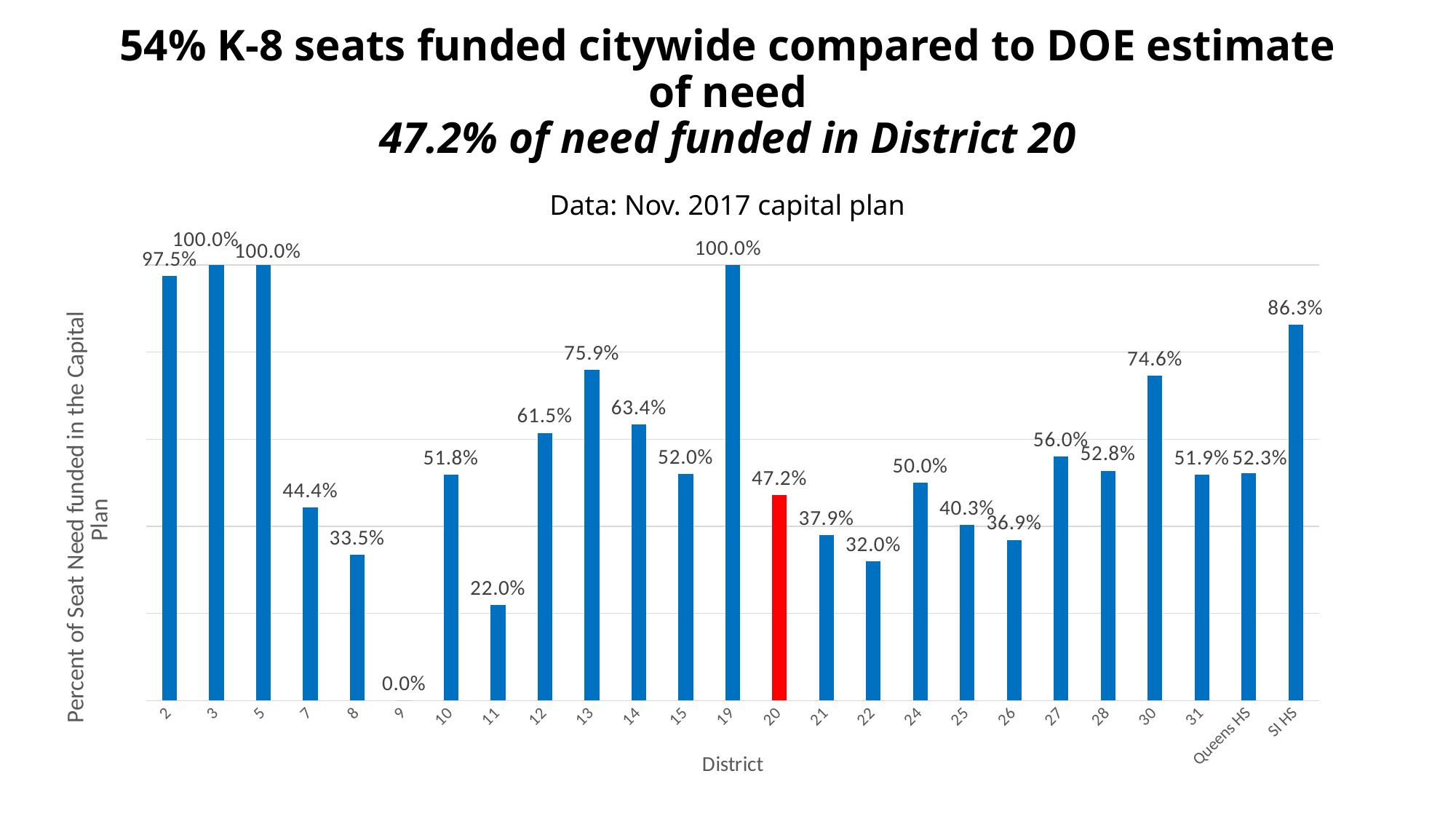
Which district's bar is coloured red? 20 What is the difference between the values for District 30 and District 26? 37.7% How many categories are shown on the x axis? 25 What is the value for Queens HS? 52.3% Which district has the lowest percent of seat need funded? 9 What is the value for District 11? 22.0% What kind of chart is shown on the slide? Bar chart Which is larger, the value for District 7 or the value for District 25? District 7 What is the difference between the values for District 13 and District 20? 28.7% What is the value for SI HS? 86.3% What is the value for District 20? 47.2% Which is larger, the value for District 12 or the value for District 14? District 14